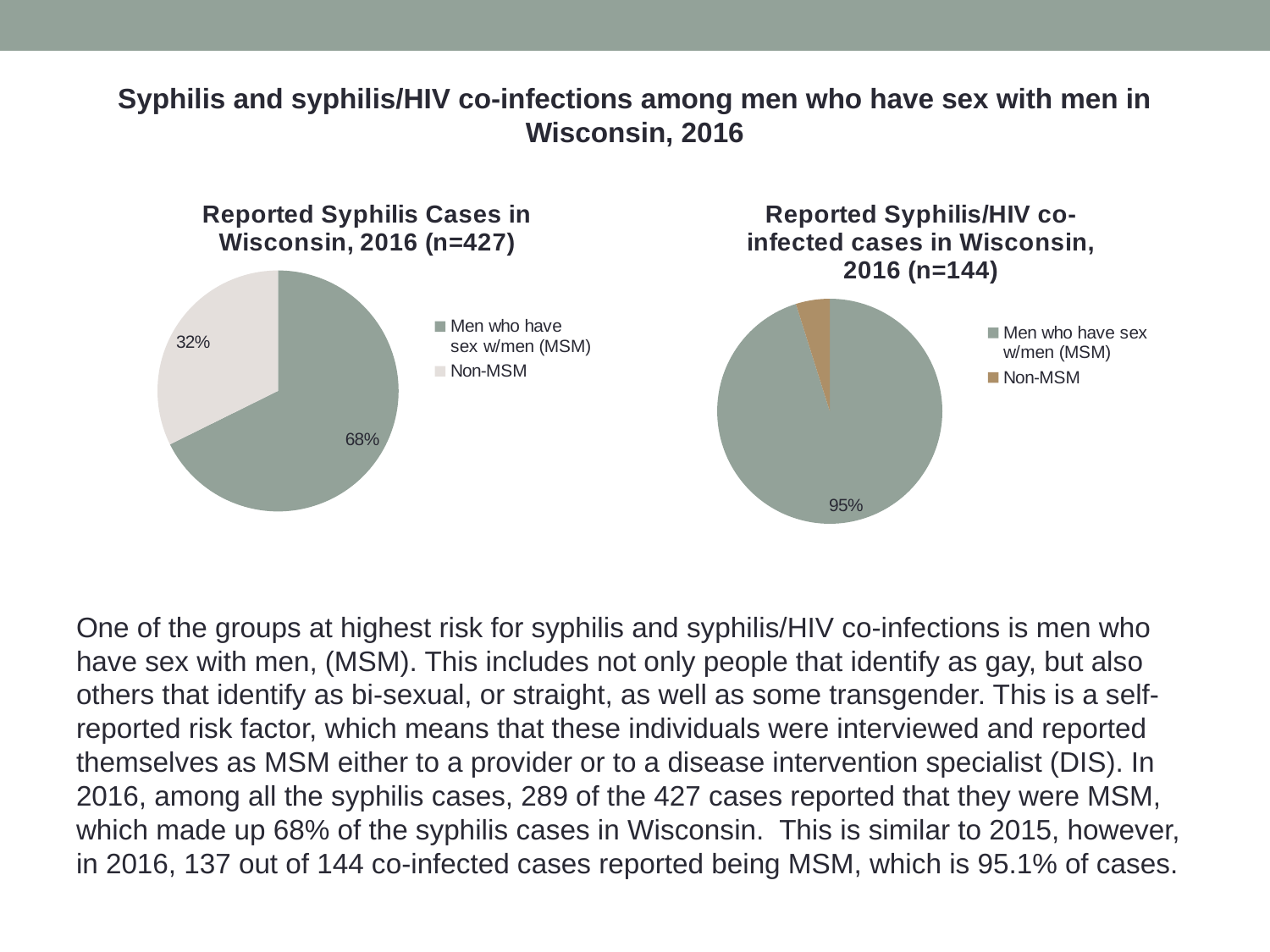
In the 'Reported Syphilis/HIV co-infected cases in Wisconsin, 2016 (n=144)' chart, which category has the smallest slice? Non-MSM How many categories does the 'Reported Syphilis/HIV co-infected cases in Wisconsin, 2016 (n=144)' chart show? 2 In the 'Reported Syphilis Cases in Wisconsin, 2016 (n=427)' chart, which category has the largest slice? Men who have sex w/men (MSM) Which chart shows a larger MSM share: the left chart (n=427) or the right chart (n=144)? The right chart (n=144) In the 'Reported Syphilis Cases in Wisconsin, 2016 (n=427)' chart, what is the difference in percentage points between the MSM and Non-MSM slices? 36 percentage points What is the title of the pie chart on the right side of the slide? Reported Syphilis/HIV co-infected cases in Wisconsin, 2016 (n=144) How many entries does the legend of the 'Reported Syphilis Cases in Wisconsin, 2016 (n=427)' chart list? 2 In the 'Reported Syphilis Cases in Wisconsin, 2016 (n=427)' chart, what share of cases is Non-MSM? 32% In the 'Reported Syphilis/HIV co-infected cases in Wisconsin, 2016 (n=144)' chart, what share of cases is Men who have sex w/men (MSM)? 95% What type of chart is the 'Reported Syphilis Cases in Wisconsin, 2016 (n=427)' chart? Pie chart In the 'Reported Syphilis Cases in Wisconsin, 2016 (n=427)' chart, what share of cases is Men who have sex w/men (MSM)? 68% In the 'Reported Syphilis/HIV co-infected cases in Wisconsin, 2016 (n=144)' chart, what colour is the Non-MSM slice? Brown/tan